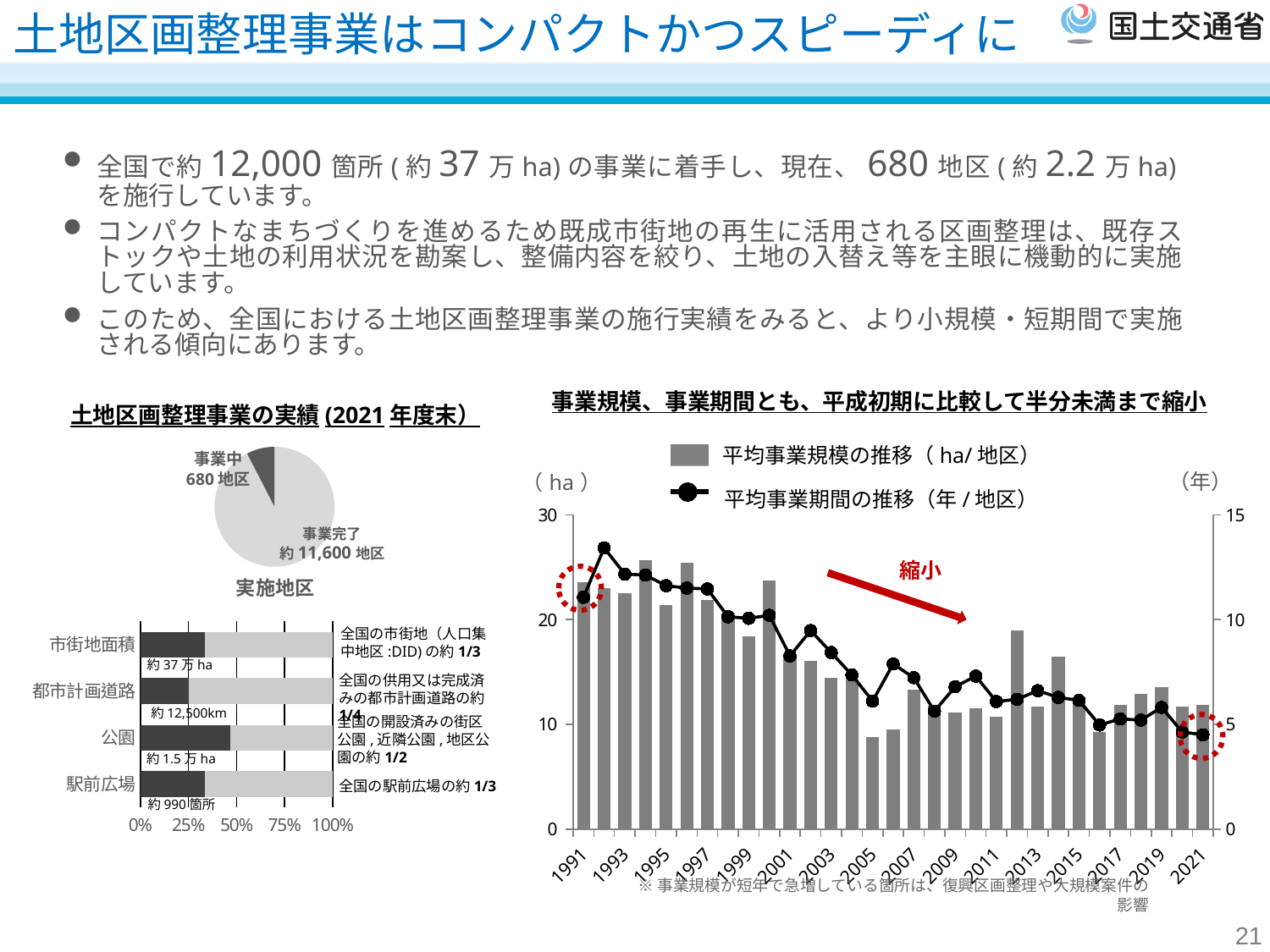
In the right-hand chart, is the bar value for 1991 greater or less than 20 ha? greater In the pie chart titled 実施地区, what value is shown for 事業完了? 約 11,600 地区 How many series does the legend of the right-hand chart (事業規模、事業期間とも…) list? 2 In the horizontal bar chart at the bottom left, which category has the largest dark share? 公園 In the horizontal bar chart at the bottom left, how many categories are shown? 4 In the right-hand chart, in which year does the line 平均事業期間の推移 reach its highest point? 1992 How many slices does the pie chart titled 実施地区 have? 2 In the pie chart titled 実施地区, how many districts are labelled as 事業中? 680 地区 In the pie chart titled 実施地区, which slice is larger, 事業中 or 事業完了? 事業完了 In the horizontal bar chart at the bottom left, what value is printed for 都市計画道路? 約 12,500km In the right-hand chart, do the bar values for 平均事業規模の推移 generally rise or fall from 1991 to 2021? fall In the horizontal bar chart at the bottom left, is the dark share for 公園 greater or less than 25%? greater